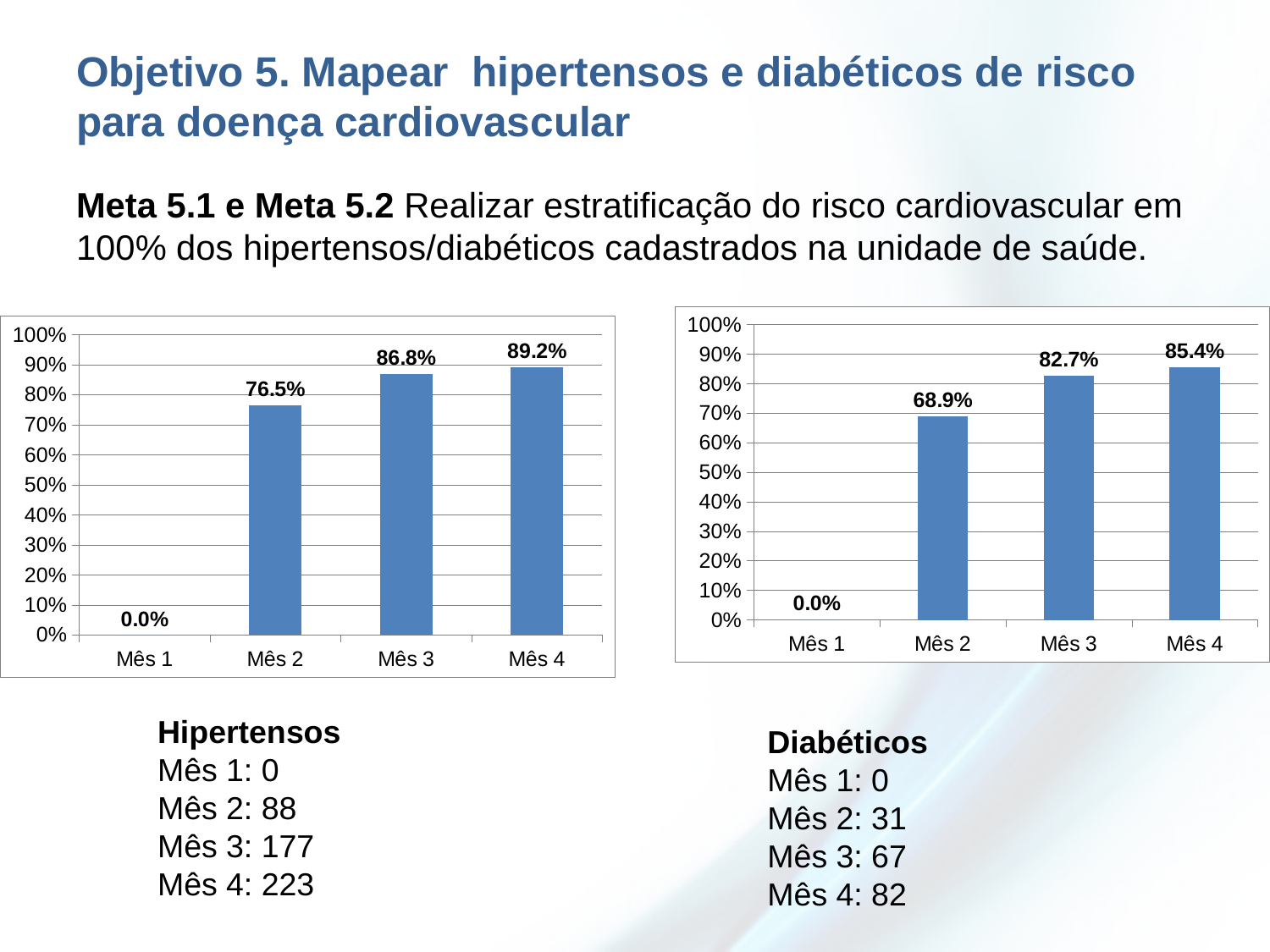
In the right chart (Diabéticos), what is the difference between the values for Mês 3 and Mês 2? 13.8% In the left chart (Hipertensos), is the value for Mês 2 greater or less than 70%? greater In the right chart (Diabéticos), which month has the lowest value? Mês 1 How many months are shown on the x axis of the left chart (Hipertensos)? 4 What kind of chart is the right chart (Diabéticos)? Bar chart In the right chart (Diabéticos), which is larger, the value for Mês 3 or Mês 4? Mês 4 In the left chart (Hipertensos), what is the difference between the values for Mês 4 and Mês 2? 12.7% In the left chart (Hipertensos), what is the value for Mês 3? 86.8% In the right chart (Diabéticos), do the values rise or fall from Mês 1 to Mês 4? Rise In the right chart (Diabéticos), what is the value for Mês 2? 68.9% In the left chart (Hipertensos), what is the value for Mês 1? 0.0% In the left chart (Hipertensos), which month has the highest value? Mês 4